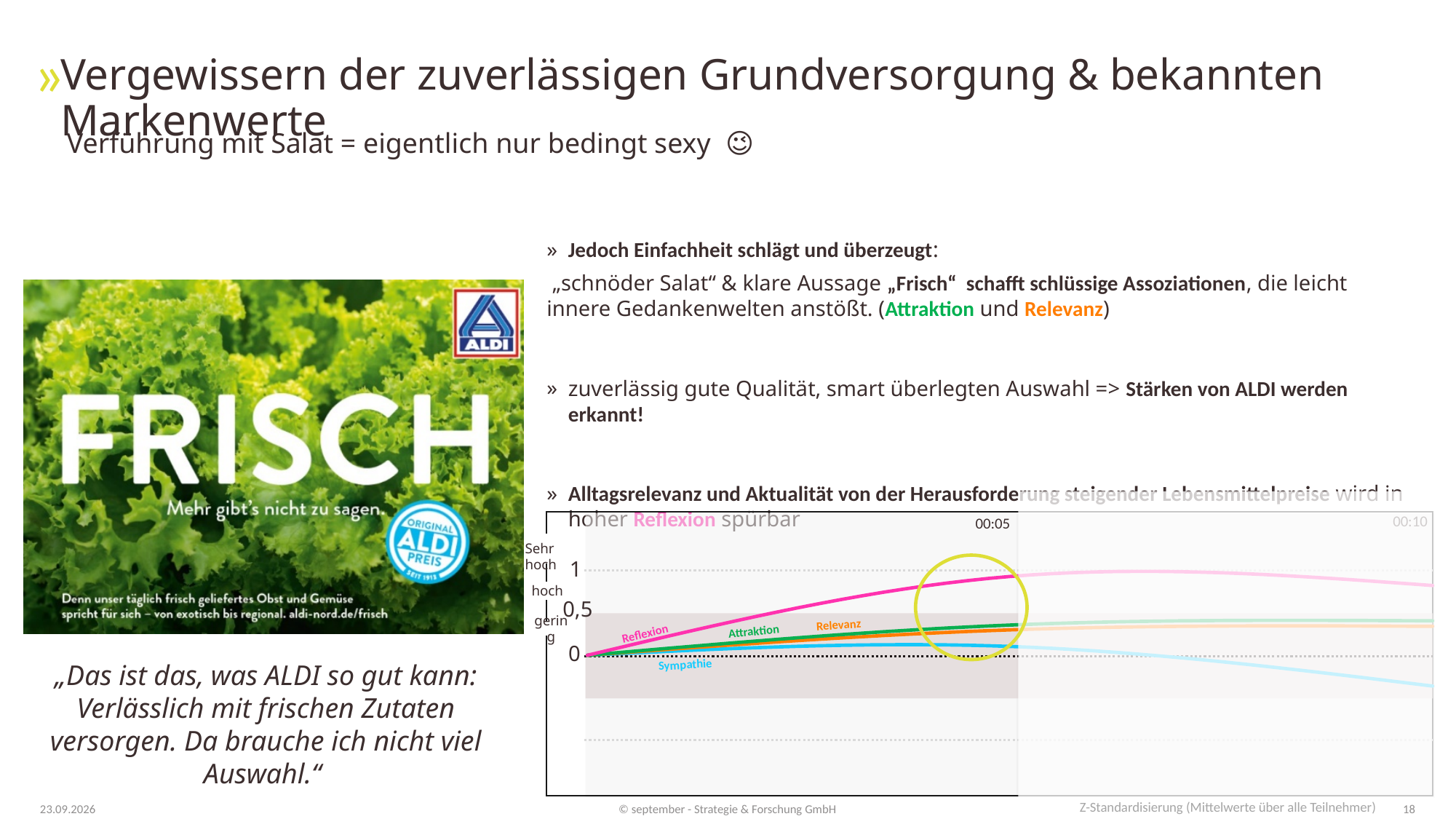
Does the Reflexion line rise or fall from the start of the chart to the 00:05 mark? rise Is the value of Reflexion at 00:05 greater or less than 0,5? greater At 00:05, which is larger: Reflexion or Sympathie? Reflexion Which series has the lowest value at the 00:10 mark? Sympathie What kind of chart is shown at the bottom right of the slide? line chart Is the value of Attraktion at 00:05 greater or less than 0,5? less Is the value of Sympathie at 00:10 greater or less than 0? less What are the two time markers shown along the top of the chart? 00:05 and 00:10 Which series is drawn in pink in the chart? Reflexion Does the Sympathie line rise or fall between 00:05 and 00:10? fall Which series has the highest value at the 00:05 mark? Reflexion How many series (lines) are labelled in the chart? 4